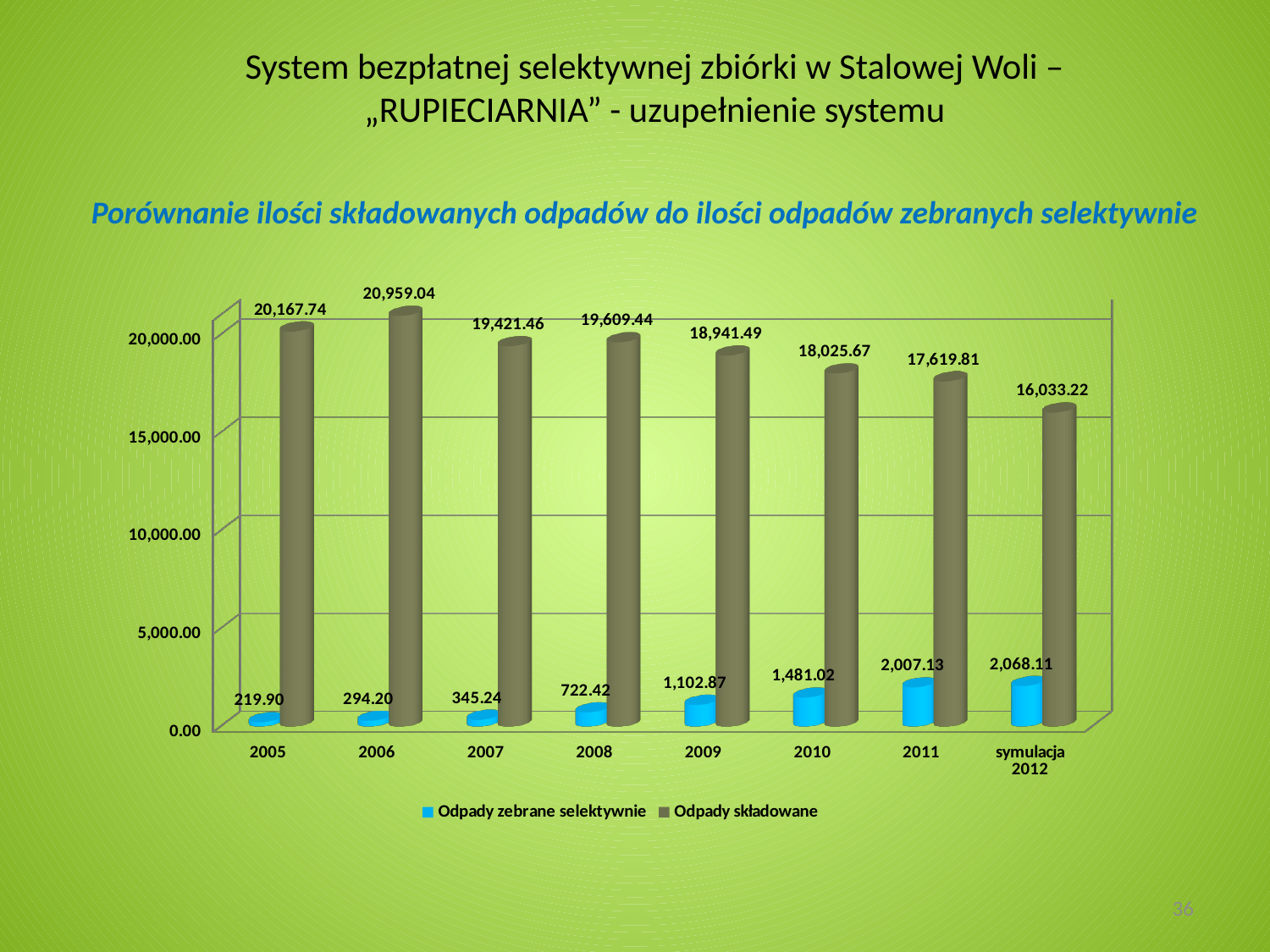
What kind of chart is shown on the slide? bar chart In which category is Odpady zebrane selektywnie lowest? 2005 How many series does the legend list? 2 What is the value of Odpady zebrane selektywnie for symulacja 2012? 2,068.11 Which is larger: Odpady zebrane selektywnie in 2010 or in 2008? 2010 How many categories are shown on the x axis? 8 What is the value of Odpady składowane for 2005? 20,167.74 By how much does Odpady składowane in 2006 exceed Odpady składowane in 2005? 791.30 What is the difference between Odpady składowane and Odpady zebrane selektywnie in 2011? 15,612.68 Do the values of Odpady zebrane selektywnie rise or fall from 2005 to symulacja 2012? rise What is the value of Odpady zebrane selektywnie for 2009? 1,102.87 In which year is Odpady składowane highest? 2006